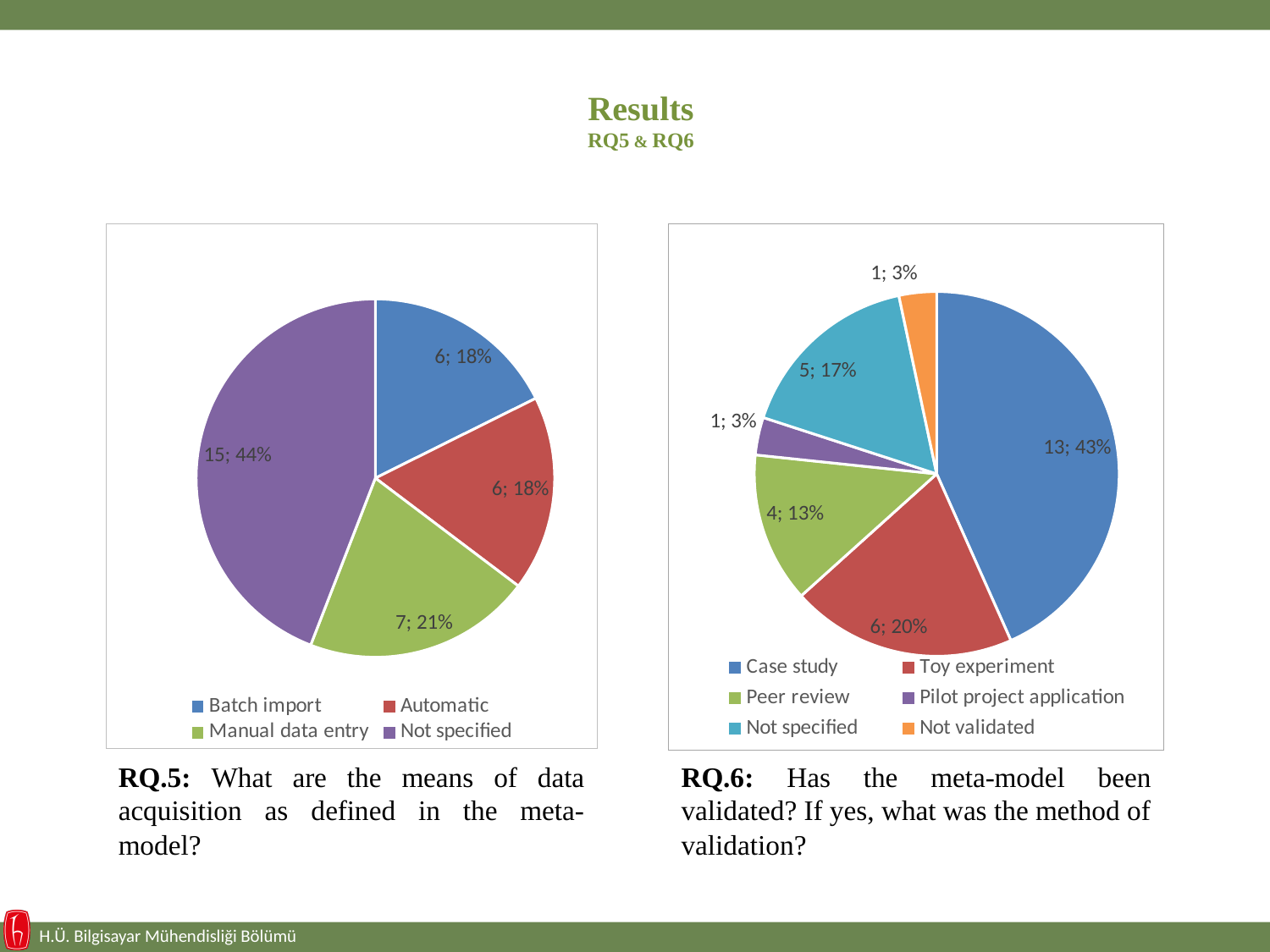
How many categories does the legend of the right pie chart list? 6 How many categories does the legend of the left pie chart list? 4 In the right pie chart, what is the value for Not specified? 5; 17% What kind of chart is the left chart on the slide? pie chart In the left pie chart, what is the value for Not specified? 15; 44% In the left pie chart, which category has the largest slice? Not specified In the left pie chart, what share of the pie does Batch import take? 18% In the left pie chart, what is the value for Manual data entry? 7; 21% In the right pie chart, which category has the largest slice? Case study In the right pie chart, which is larger, Peer review or Not specified? Not specified In the right pie chart, what is the difference in count between Case study and Toy experiment? 7 In the right pie chart, what is the value for Case study? 13; 43%